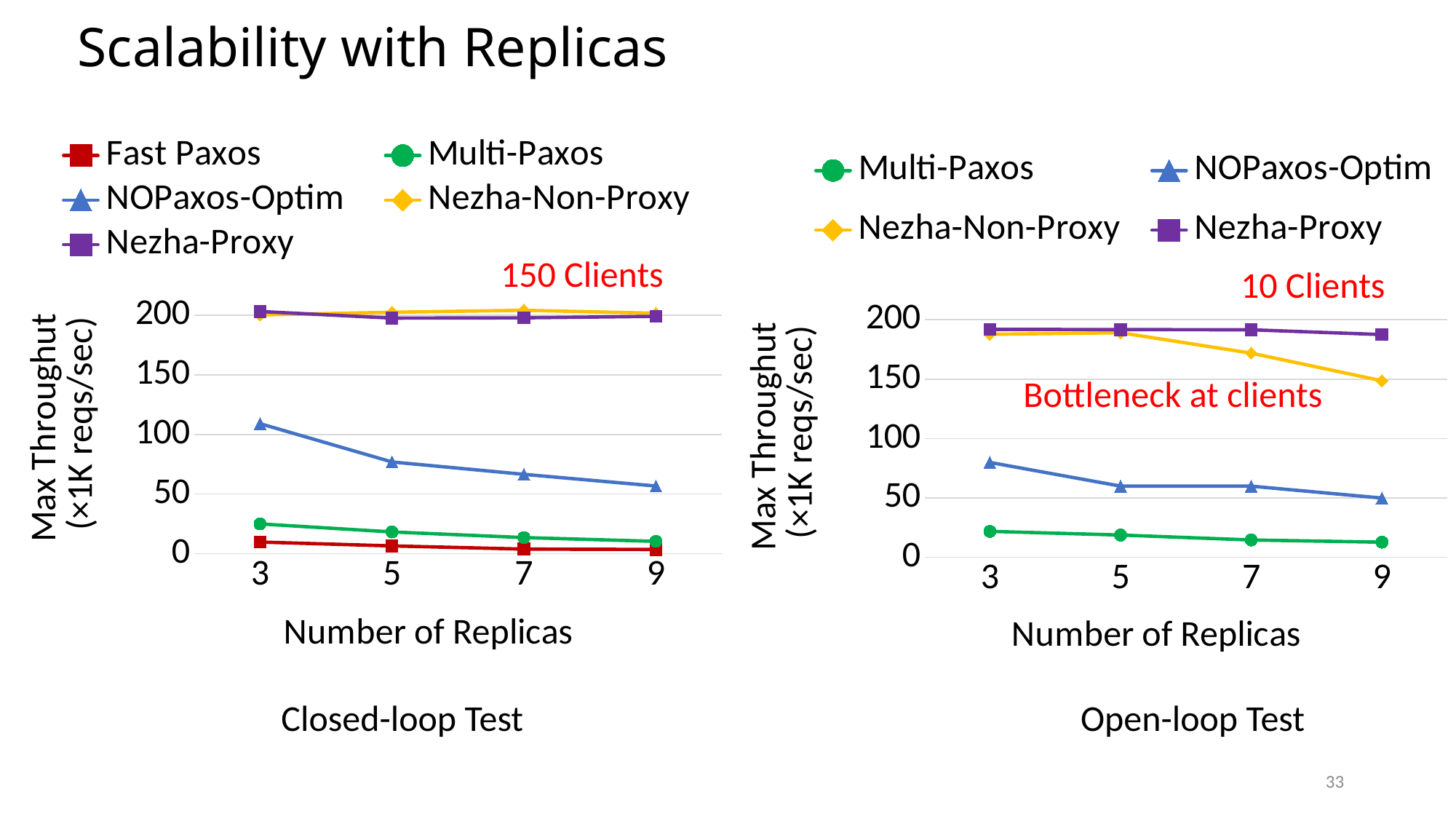
In the Open-loop Test chart, is the value for Nezha-Non-Proxy at 7 replicas greater or less than 150? greater How many series does the legend of the Open-loop Test chart list? 4 In the Closed-loop Test chart, is the value for NOPaxos-Optim at 3 replicas greater or less than 100? greater In the Open-loop Test chart, is the value for NOPaxos-Optim at 3 replicas greater or less than 100? less In the Open-loop Test chart, which is larger at 9 replicas: Nezha-Proxy or Nezha-Non-Proxy? Nezha-Proxy How many series does the legend of the Closed-loop Test chart list? 5 How many replica counts are plotted along the x axis of the Open-loop Test chart? 4 What kind of chart is the Closed-loop Test chart on the left? line chart How many clients are used in the Open-loop Test chart, according to the annotation? 10 Clients In the Open-loop Test chart, does the Nezha-Non-Proxy line rise or fall as the number of replicas increases? fall In the Closed-loop Test chart, does the NOPaxos-Optim line rise or fall as the number of replicas increases? fall